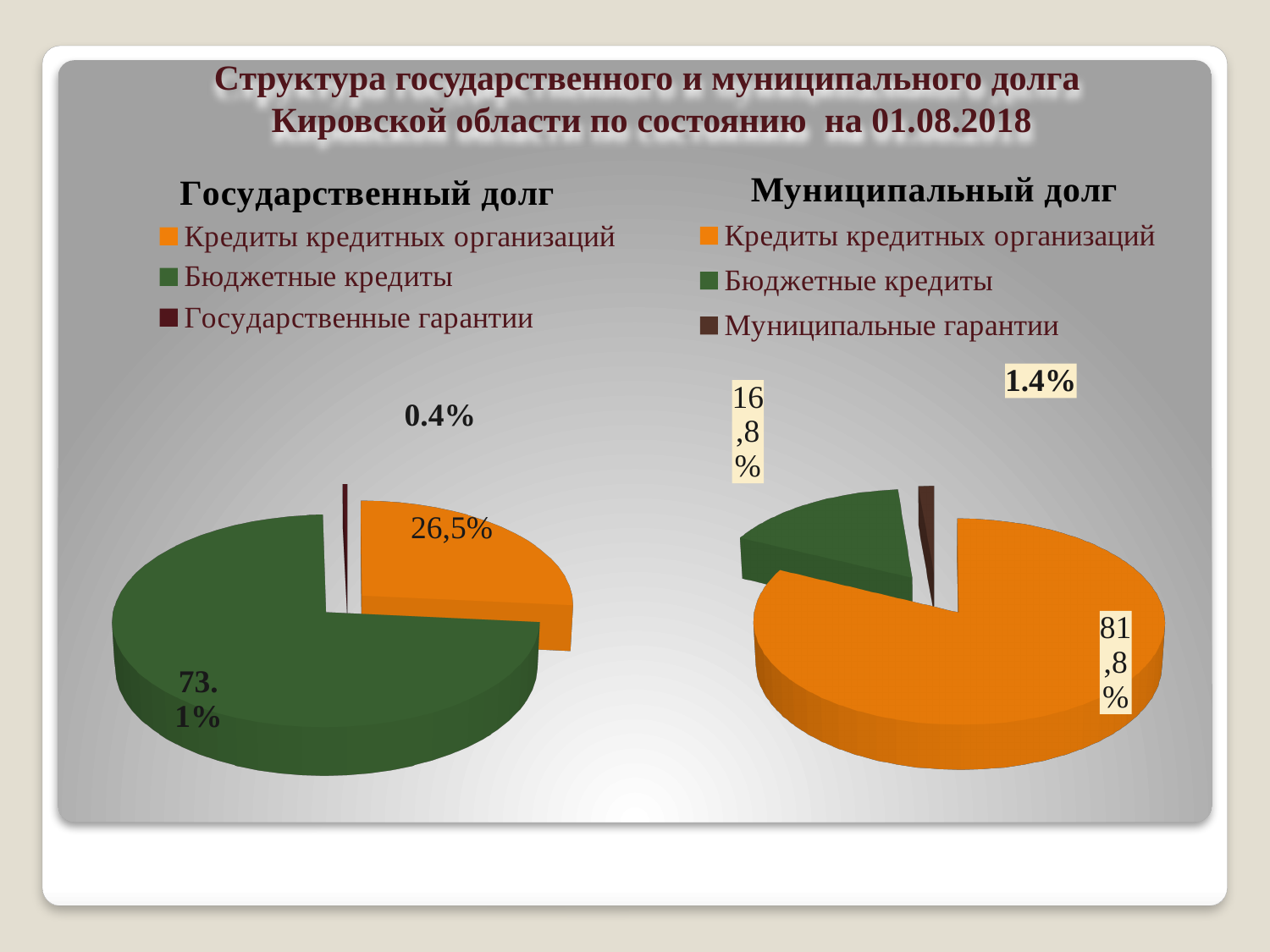
In the "Государственный долг" chart, which category has the largest share? Бюджетные кредиты In the "Государственный долг" chart, what colour is the slice for Бюджетные кредиты? Green In the "Государственный долг" chart, what share is shown for Государственные гарантии? 0.4% How many categories does the legend of the "Муниципальный долг" chart list? 3 In the "Муниципальный долг" chart, what share is shown for Бюджетные кредиты? 16,8% In the "Муниципальный долг" chart, which is larger: Кредиты кредитных организаций or Бюджетные кредиты? Кредиты кредитных организаций What type of chart is the "Государственный долг" chart? Pie chart In the "Муниципальный долг" chart, which category has the smallest share? Муниципальные гарантии In the "Государственный долг" chart, what share is shown for Кредиты кредитных организаций? 26,5% In the "Муниципальный долг" chart, what share is shown for Кредиты кредитных организаций? 81,8% In the "Муниципальный долг" chart, what share is shown for Муниципальные гарантии? 1.4% In the "Государственный долг" chart, what share is shown for Бюджетные кредиты? 73.1%